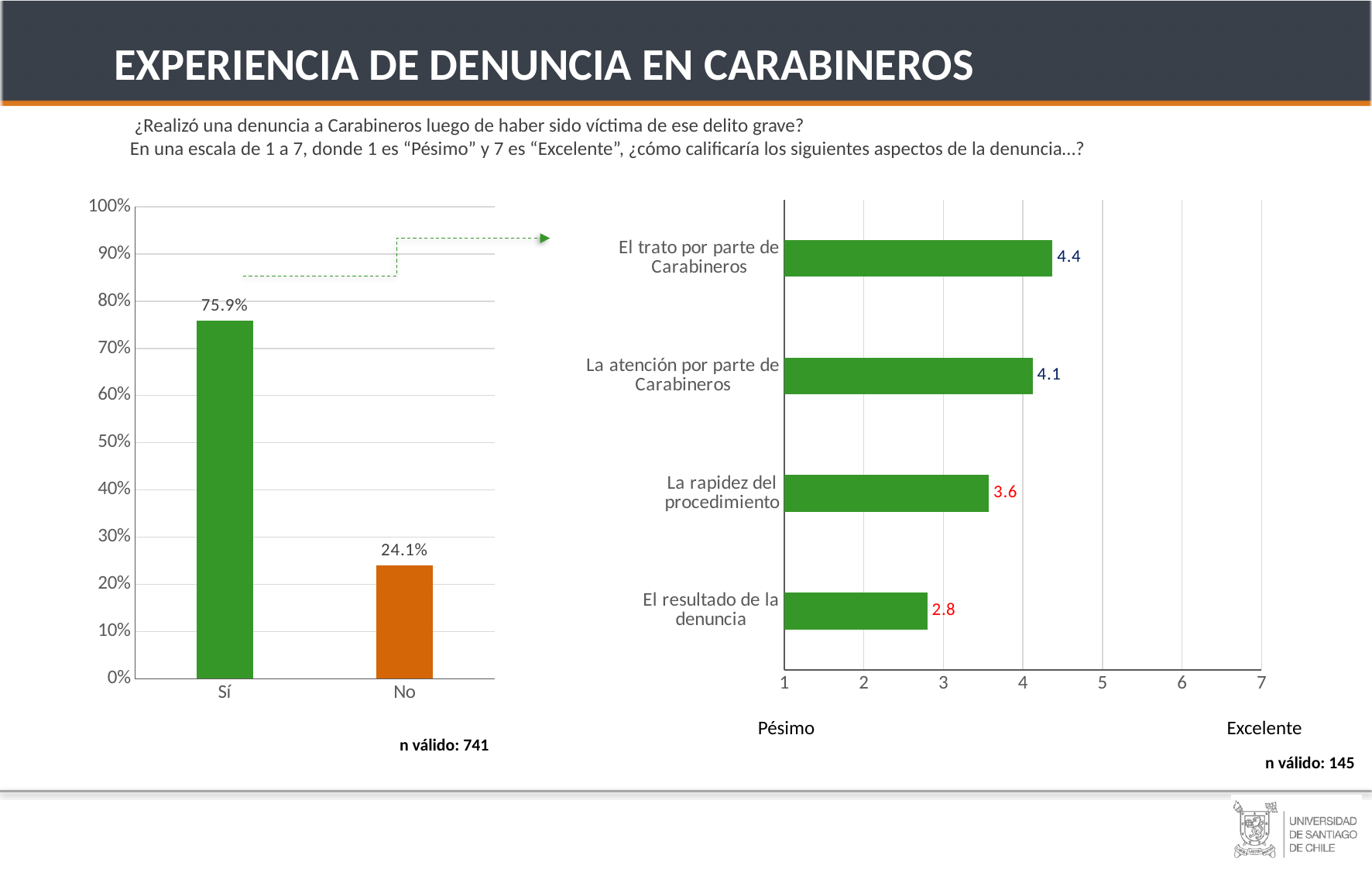
What kind of chart is the chart on the right? Bar chart In the left chart, what percentage of respondents answered "No"? 24.1% In the left chart, which category has the higher value, Sí or No? Sí In the right chart, what is the rating for "El resultado de la denuncia"? 2.8 In the right chart, how many aspects of the denuncia are rated? 4 In the left chart, what percentage of respondents answered "Sí"? 75.9% In the left chart, what is the difference between the Sí and No percentages? 51.8% In the left chart, how many categories are shown on the x axis? 2 In the right chart, which aspect has the highest rating? El trato por parte de Carabineros In the right chart, what is the difference between the ratings for "La atención por parte de Carabineros" and "La rapidez del procedimiento"? 0.5 In the right chart, what is the rating for "El trato por parte de Carabineros"? 4.4 In the right chart, which aspect has the lowest rating? El resultado de la denuncia